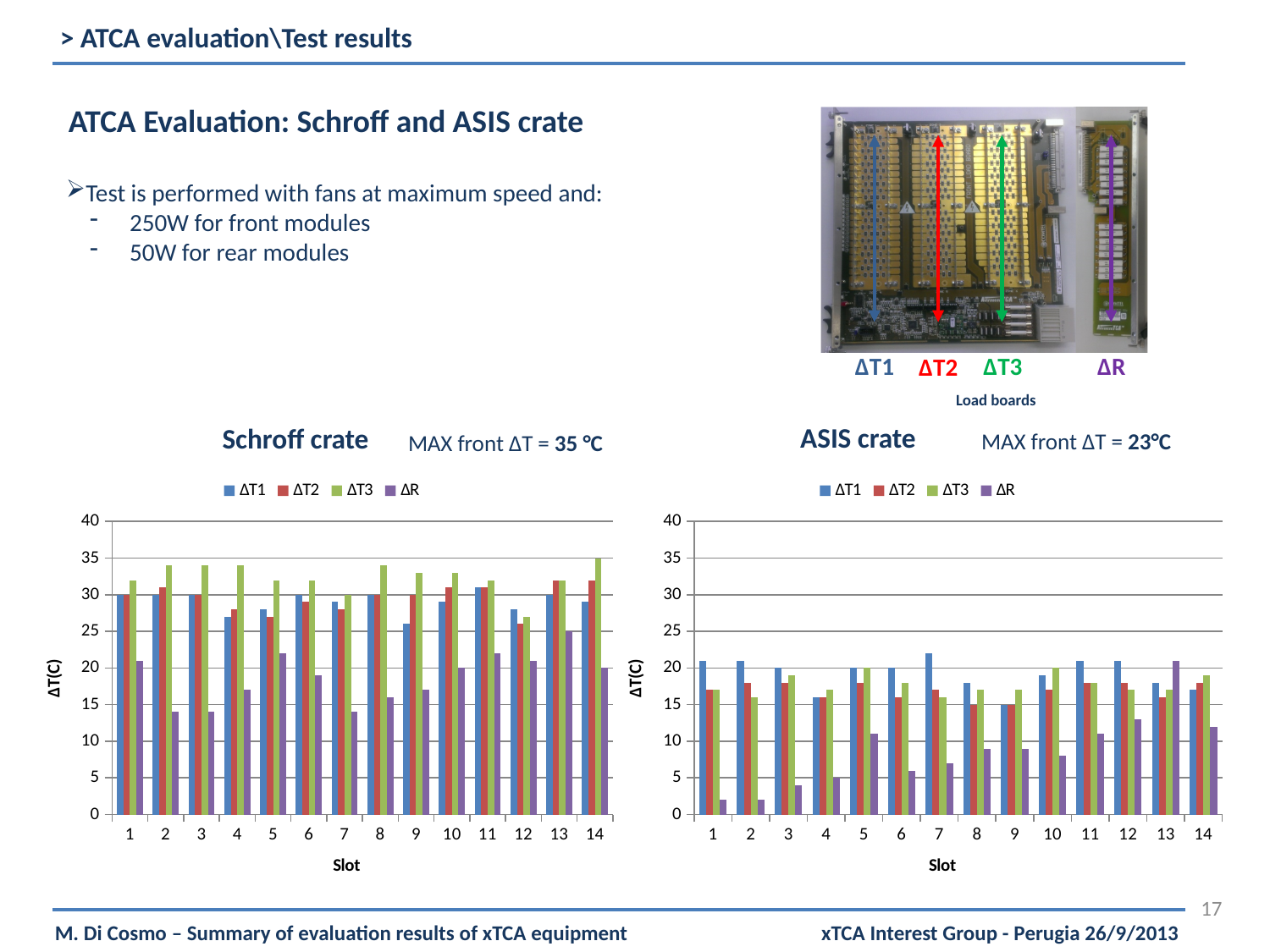
In the ASIS crate chart, which is larger for slot 1: ΔT1 or ΔR? ΔT1 What kind of chart is the Schroff crate chart? bar chart How many slots are shown on the x axis of the Schroff crate chart? 14 What is the label of the y axis on the ASIS crate chart? ΔT(C) In the Schroff crate chart, which is larger for slot 2: ΔT3 or ΔR? ΔT3 In the Schroff crate chart, is the ΔT3 value for slot 2 greater or less than 30? greater In the ASIS crate chart, is the ΔR value for slot 1 greater or less than 5? less How many series does the legend of the ASIS crate chart list? 4 In the Schroff crate chart, which slot has the highest ΔR value? 13 In the Schroff crate chart, is the ΔR value for slot 2 greater or less than 20? less How many slots are shown on the x axis of the ASIS crate chart? 14